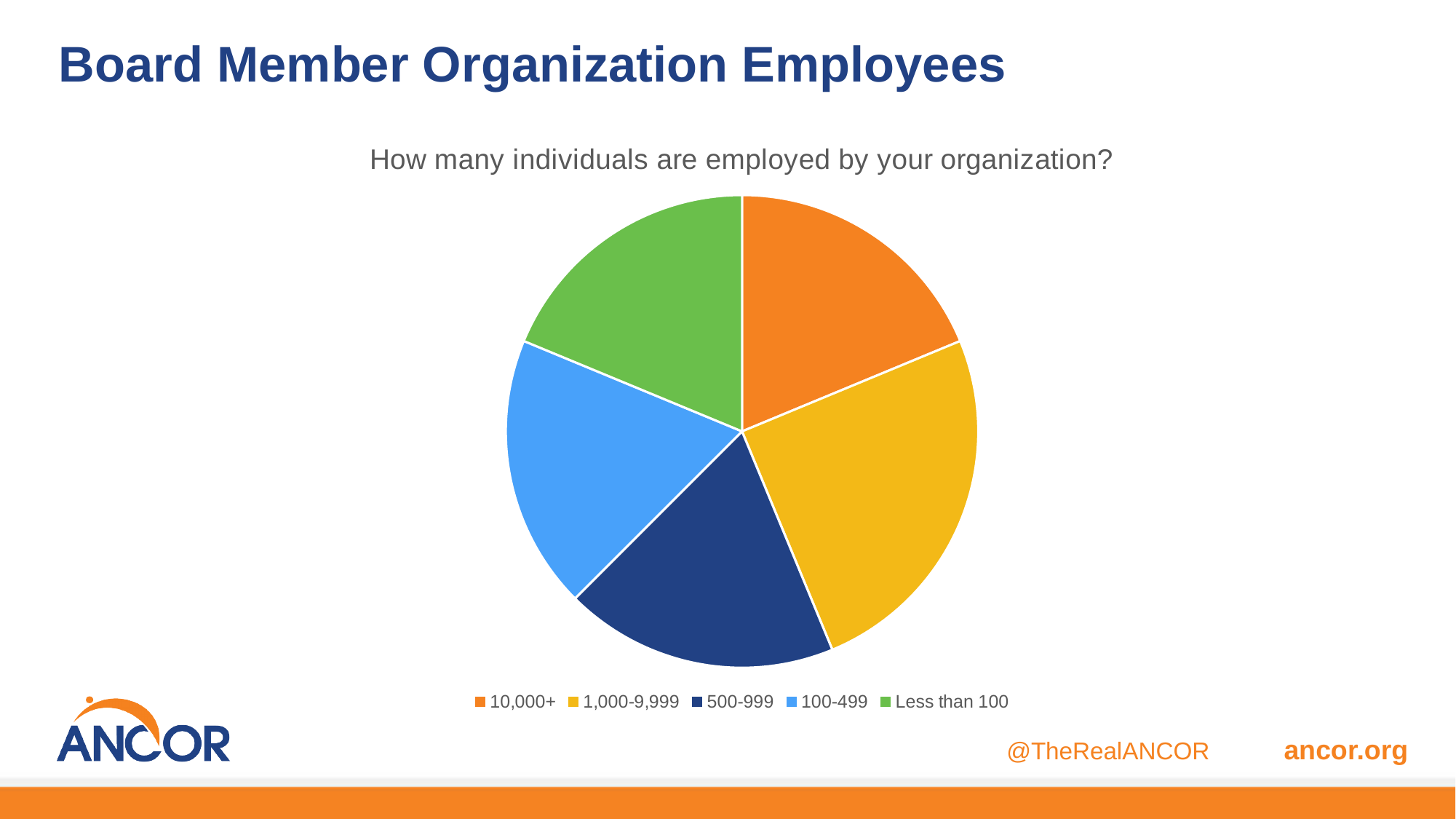
Which slice is larger, 1,000-9,999 or 10,000+? 1,000-9,999 How many slices does the pie chart have? 5 Which slice is larger, 1,000-9,999 or Less than 100? 1,000-9,999 What kind of chart is shown on the slide? pie chart How many entries does the legend of the pie chart list? 5 Which slice is larger, 1,000-9,999 or 500-999? 1,000-9,999 Which category has the largest slice of the pie chart? 1,000-9,999 What colour is the slice for the 10,000+ category? orange What is the title of the pie chart? How many individuals are employed by your organization?